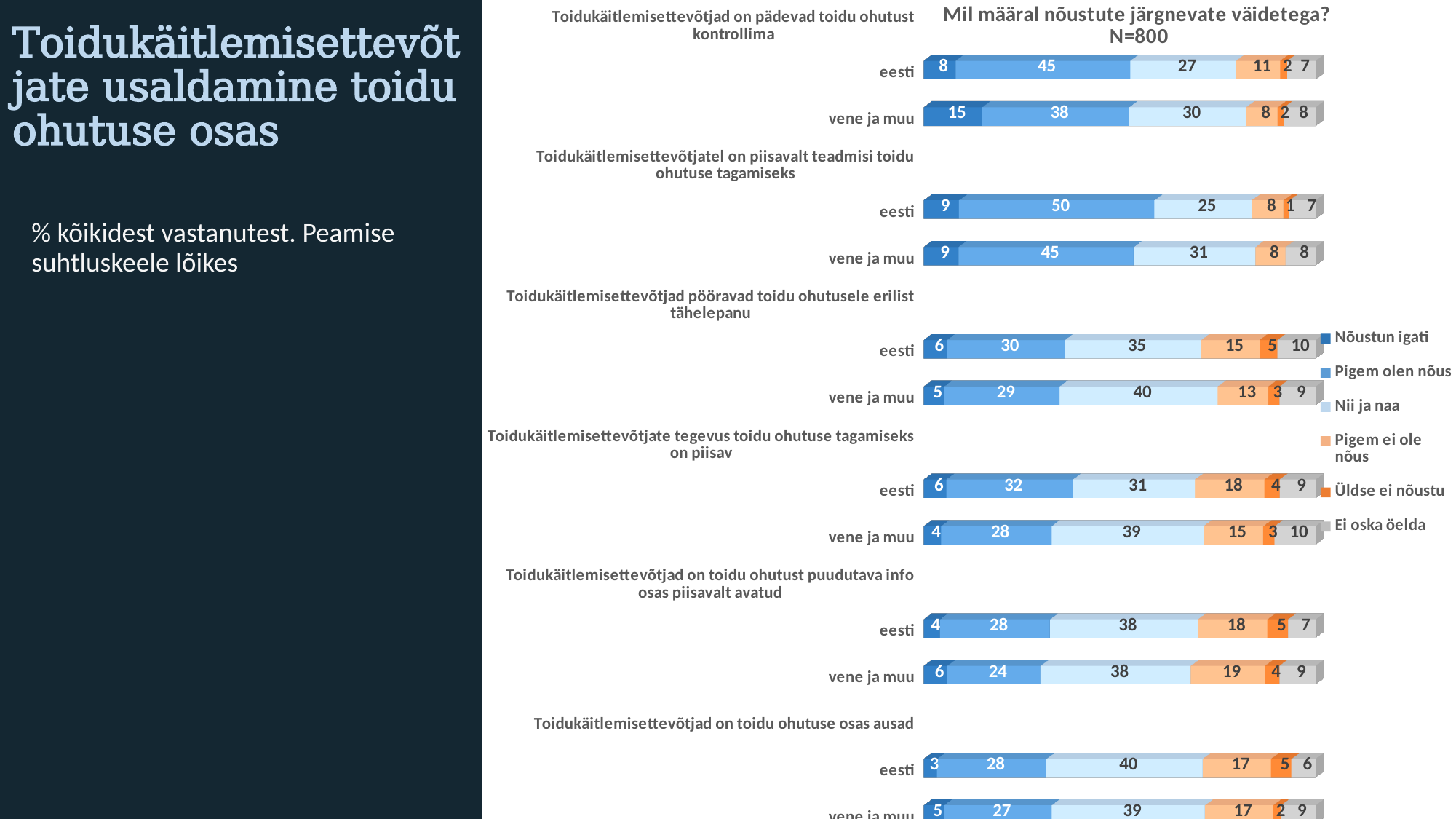
What is the difference between the 'Pigem olen nõus' values for 'eesti' and 'vene ja muu' on the statement 'Toidukäitlemisettevõtjad on pädevad toidu ohutust kontrollima'? 7 How many statements (question groups) are shown in the chart? 6 What is the sample size (N) shown in the chart title? N=800 Which has the larger 'Pigem ei ole nõus' value on the statement 'Toidukäitlemisettevõtjad on toidu ohutust puudutava info osas piisavalt avatud': 'eesti' or 'vene ja muu'? vene ja muu What is the 'Ei oska öelda' value for 'eesti' on the statement 'Toidukäitlemisettevõtjad on toidu ohutuse osas ausad'? 6 Across all 'eesti' rows, which statement has the highest 'Pigem olen nõus' value? Toidukäitlemisettevõtjatel on piisavalt teadmisi toidu ohutuse tagamiseks What is the 'Pigem olen nõus' value for 'eesti' on the statement 'Toidukäitlemisettevõtjatel on piisavalt teadmisi toidu ohutuse tagamiseks'? 50 What is the total of the stacked bar for 'eesti' on the statement 'Toidukäitlemisettevõtjad on pädevad toidu ohutust kontrollima'? 100 How many series does the legend list? 6 What is the 'Nõustun igati' value for 'vene ja muu' on the statement 'Toidukäitlemisettevõtjad on pädevad toidu ohutust kontrollima'? 15 What kind of chart is shown on the slide? stacked bar chart What is the 'Nii ja naa' value for 'vene ja muu' on the statement 'Toidukäitlemisettevõtjad pööravad toidu ohutusele erilist tähelepanu'? 40